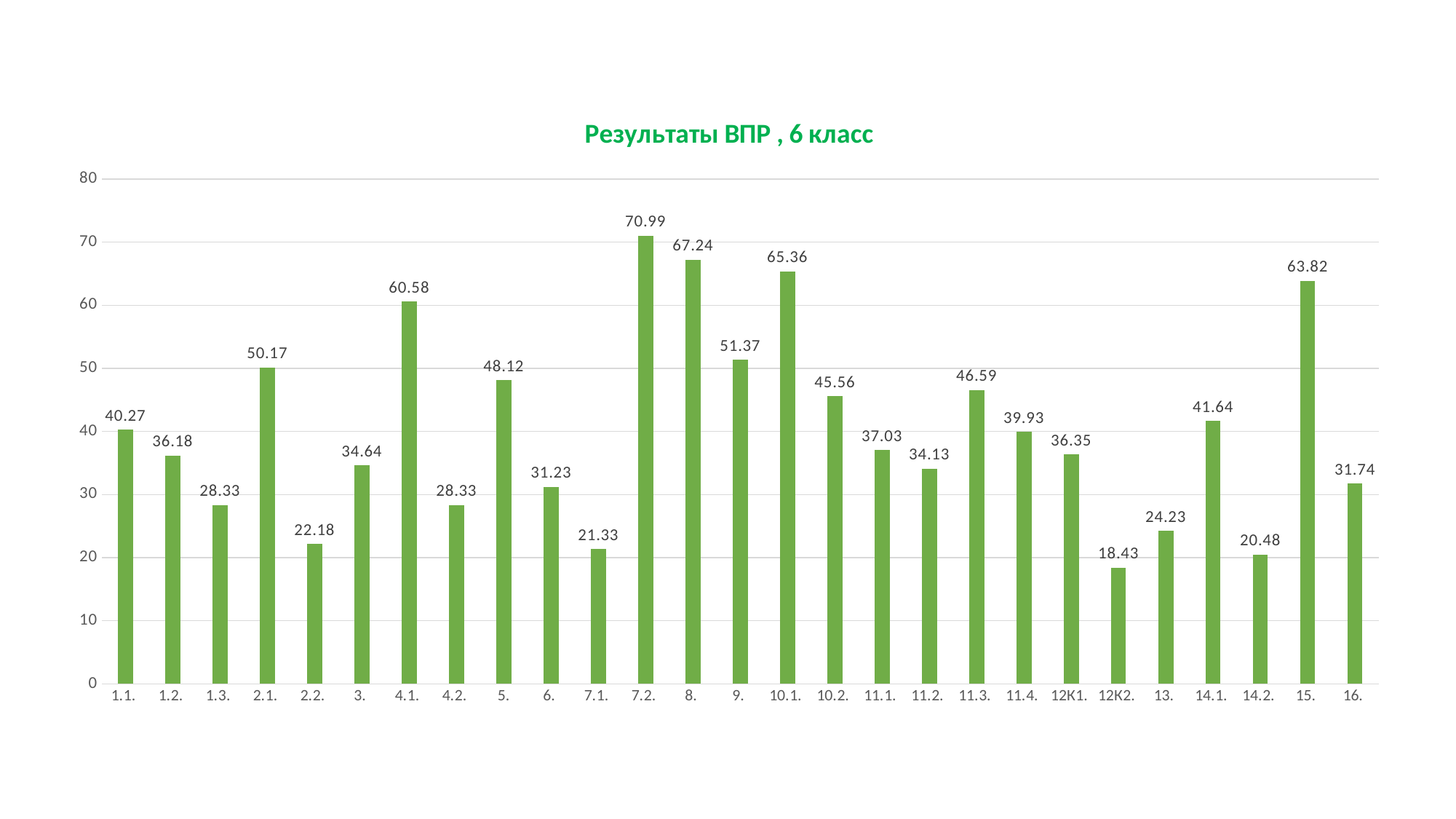
Which category has the highest value? 7.2. What is the title of the chart? Результаты ВПР , 6 класс What is the difference between the values for 4.1. and 2.1.? 10.41 Is the value for 9. greater or less than 50? greater How many categories are shown on the x axis? 27 Which is larger, the value for 10.1. or the value for 15.? 10.1. What is the value for category 7.2.? 70.99 What kind of chart is shown on the slide? bar chart What is the difference between the values for 7.2. and 8.? 3.75 What is the value for category 15.? 63.82 What is the value for category 12К2.? 18.43 Which category has the lowest value? 12К2.